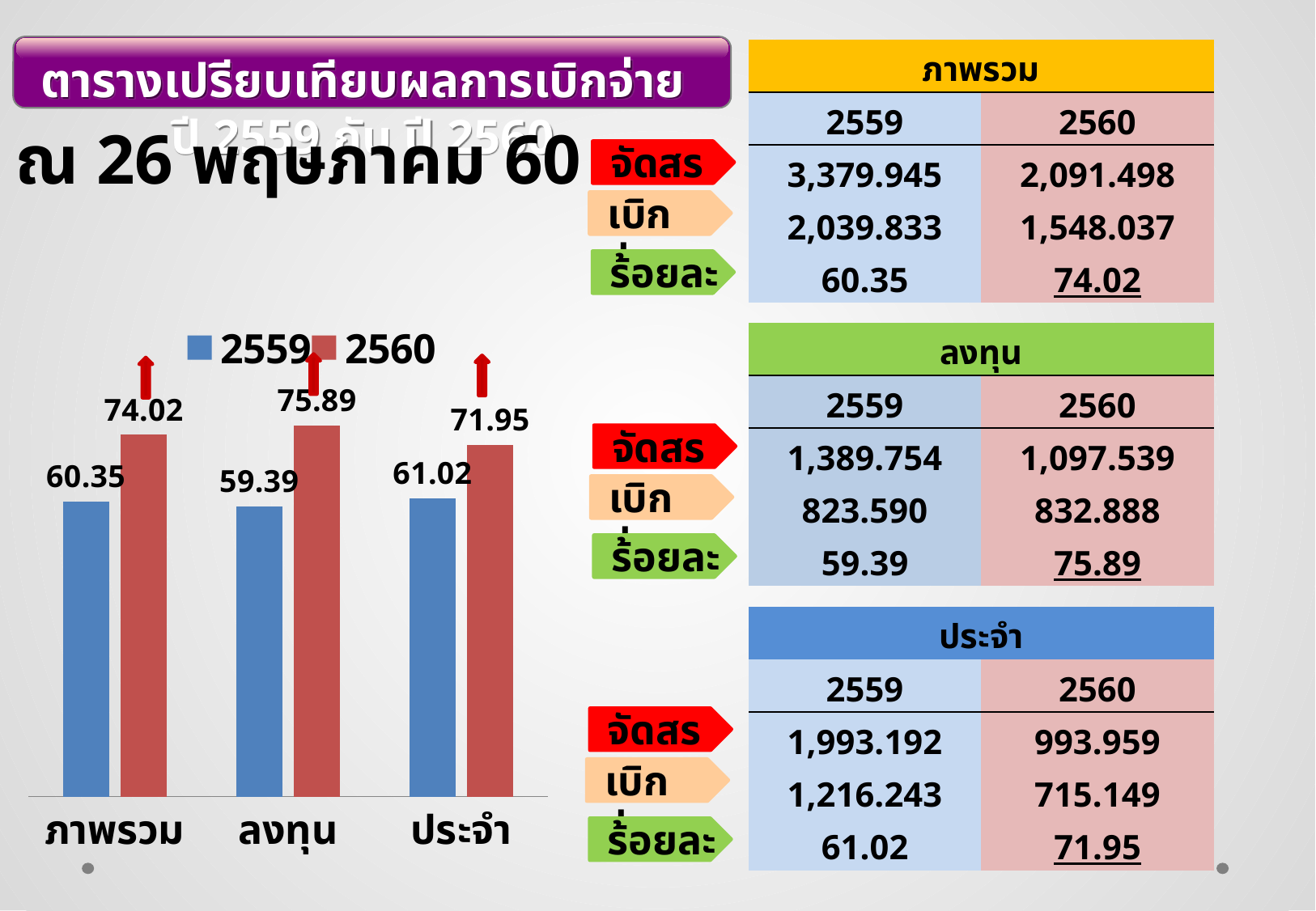
What is the value for ลงทุน in the 2559 series? 59.39 For ประจำ, which series has the larger value, 2559 or 2560? 2560 Which category has the highest value in the 2560 series? ลงทุน What is the value for ภาพรวม in the 2560 series? 74.02 What is the value for ประจำ in the 2560 series? 71.95 What kind of chart is shown on the slide? bar chart How many series does the chart legend list? 2 What is the difference between the 2560 and 2559 values for ภาพรวม? 13.67 Which category has the lowest value in the 2559 series? ลงทุน What is the difference between the 2560 and 2559 values for ลงทุน? 16.50 How many categories are shown on the x axis of the chart? 3 Which colour represents the 2560 series in the chart? red